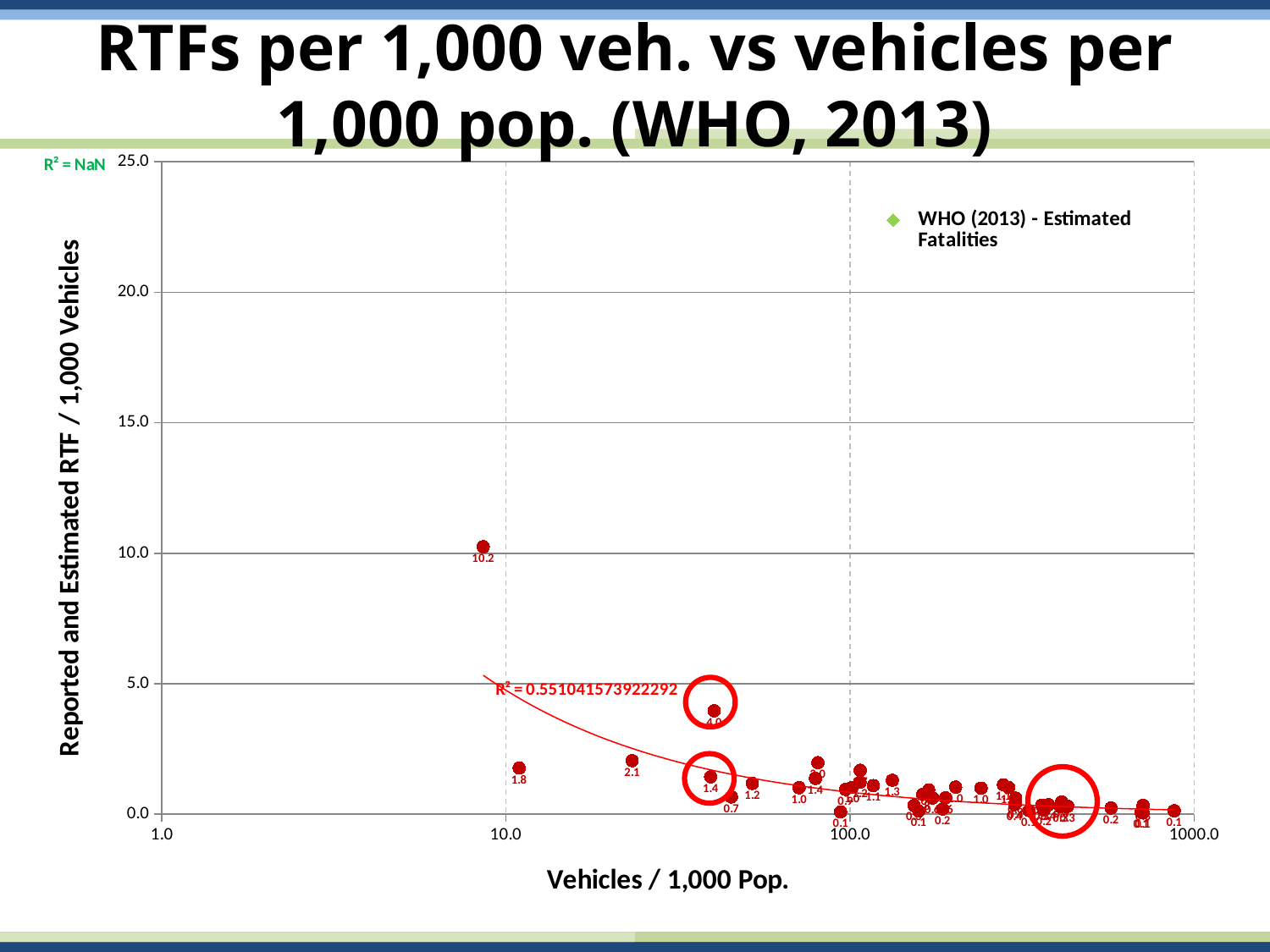
What is the difference between the highest labelled point (10.2) and the labelled point at 4.0? 6.2 What is the title of the chart? RTFs per 1,000 veh. vs vehicles per 1,000 pop. (WHO, 2013) What is the R² value printed next to the trendline on the chart? 0.551041573922292 What is the label of the x axis? Vehicles / 1,000 Pop. What is the name of the series shown in the legend? WHO (2013) - Estimated Fatalities Do the plotted RTF values generally rise or fall as vehicles per 1,000 population increases along the x axis? Fall How many series does the legend list? 1 What is the highest data-labelled value plotted on the chart? 10.2 What is the maximum value shown on the y axis? 25.0 What kind of chart is shown on the slide? Scatter chart Which is larger: the point labelled 10.2 or the point labelled 4.0? 10.2 Is the highest plotted point greater or less than 5.0 on the y axis? greater